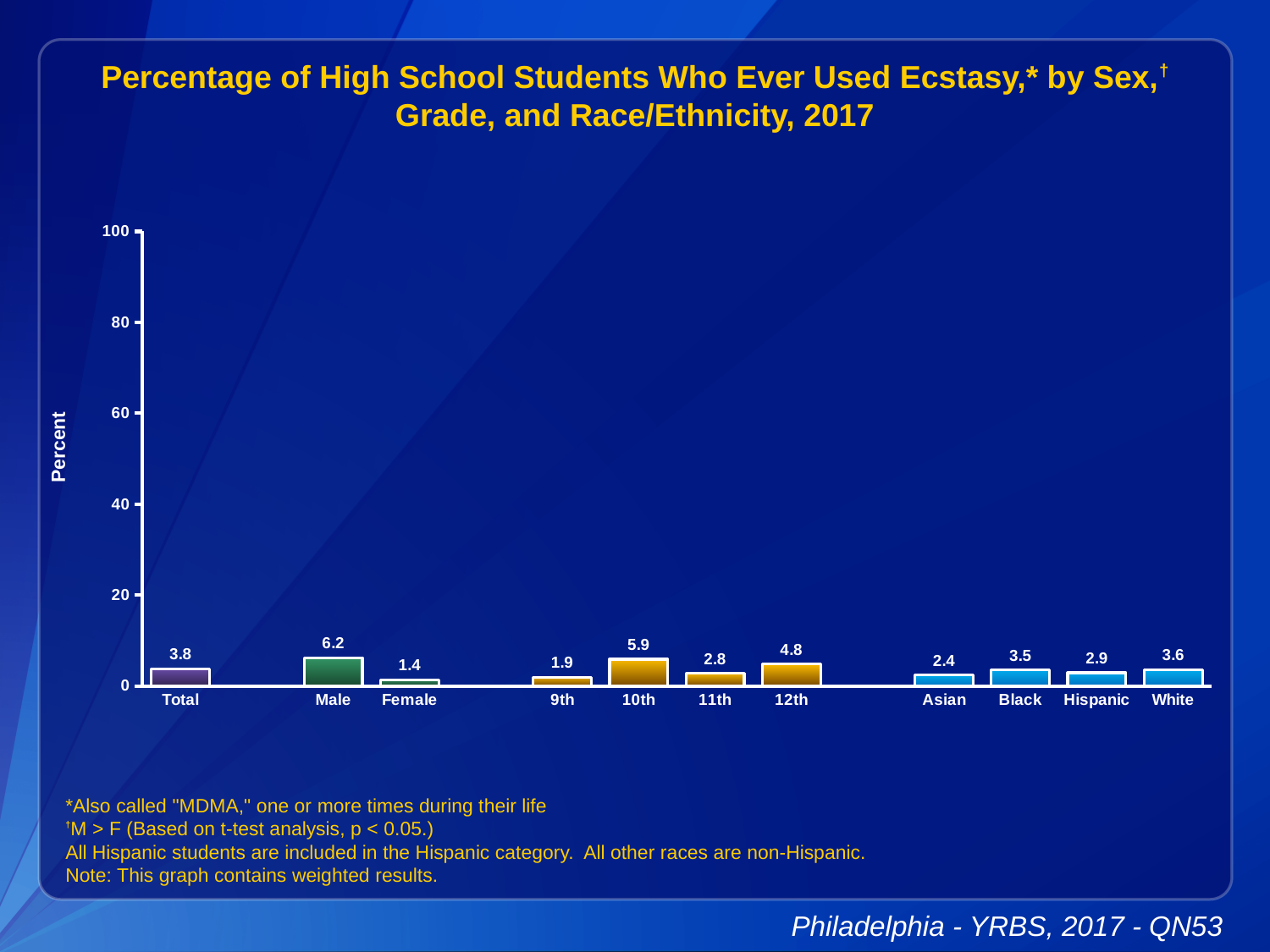
What is the value for 10th grade? 5.9 What kind of chart is this? bar chart What is the difference between the Male and Female values? 4.8 What is the label on the y axis? Percent Is the value for Male greater or less than 20? less Which is larger, the value for 12th grade or the value for 11th grade? 12th How many categories are shown on the x axis? 11 What is the value for Male? 6.2 Which category has the highest value? Male What is the value for Total? 3.8 Which category has the lowest value? Female What is the value for Hispanic? 2.9